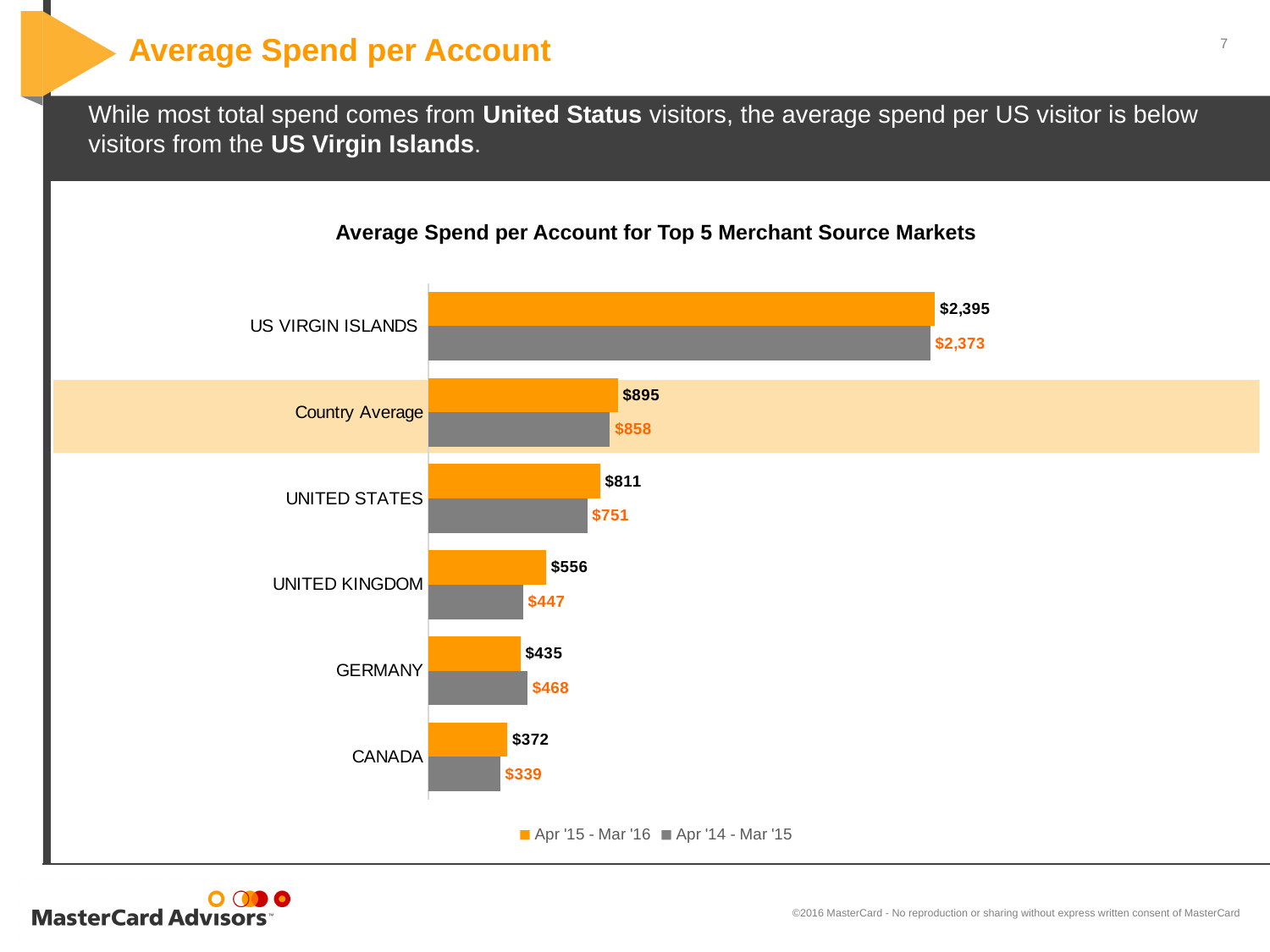
What is the title of the chart? Average Spend per Account for Top 5 Merchant Source Markets Which is larger for Germany: the Apr '15 - Mar '16 value or the Apr '14 - Mar '15 value? Apr '14 - Mar '15 What is the difference between the US Virgin Islands values for Apr '15 - Mar '16 and Apr '14 - Mar '15? $22 What is the difference between the United Kingdom values for Apr '15 - Mar '16 and Apr '14 - Mar '15? $109 How many series does the legend list? 2 What kind of chart is shown on the slide? Bar chart How many categories are shown on the chart, including Country Average? 6 Which category has the highest average spend per account in Apr '15 - Mar '16? US Virgin Islands Which category has the lowest average spend per account in Apr '14 - Mar '15? Canada What is the average spend per account for the United States in Apr '15 - Mar '16? $811 What is the Country Average value for Apr '15 - Mar '16? $895 What is the average spend per account for Germany in Apr '14 - Mar '15? $468